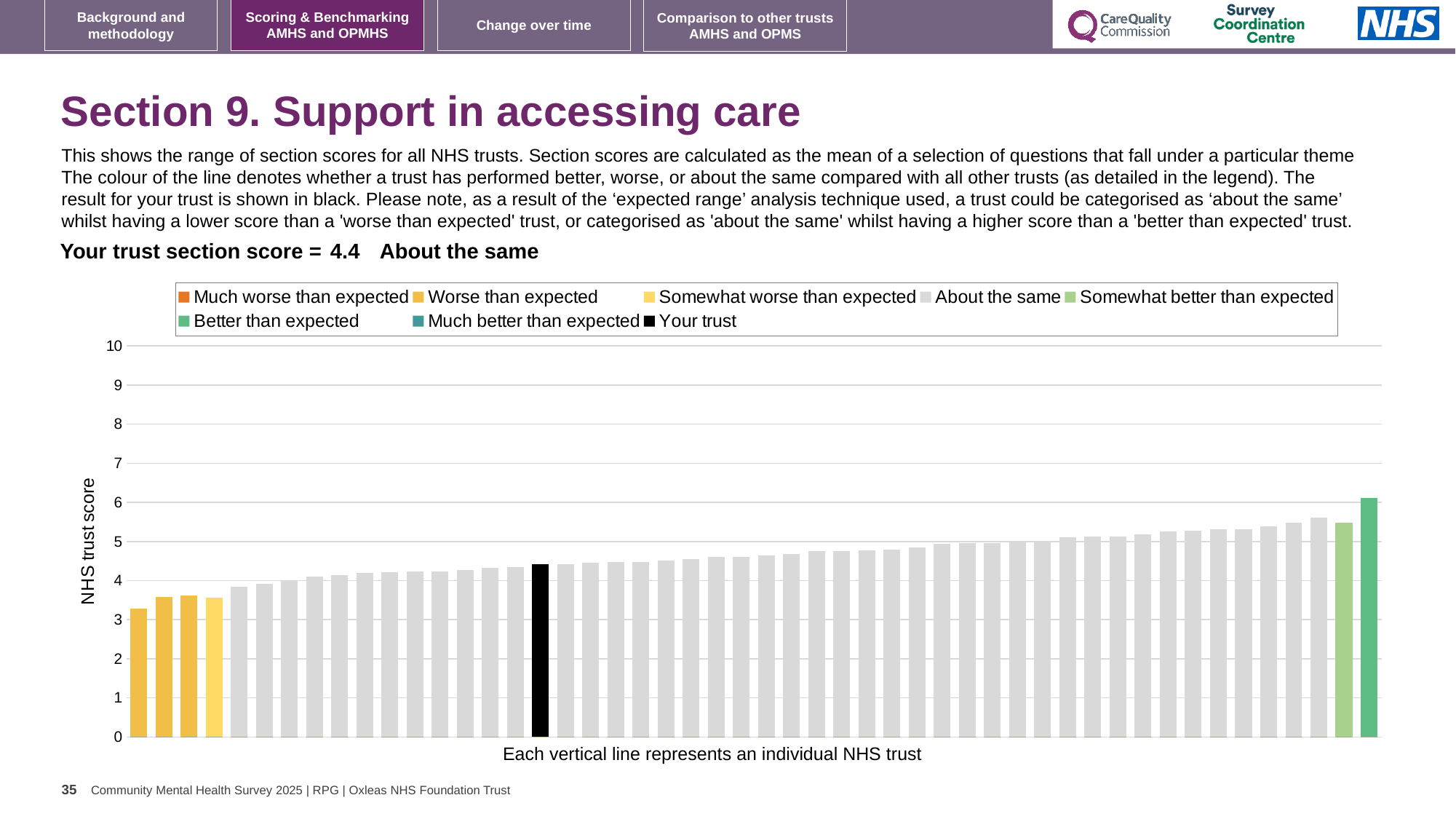
Which category is your trust placed in for this section? About the same What is the section score for your trust shown on the slide? 4.4 What colour is the bar representing your trust? black What kind of chart is shown on the slide? bar chart What is the label on the y axis of the chart? NHS trust score Do the bar values rise or fall from left to right along the x axis? rise Is the value of the leftmost bar greater or less than 4? less Is the leftmost bar larger or smaller than the black 'Your trust' bar? smaller Is the value of the tallest bar greater or less than 5? greater Is the value of the black 'Your trust' bar greater or less than 5? less How many entries does the chart legend list? 8 How many bars are coloured yellow (worse than expected)? 3